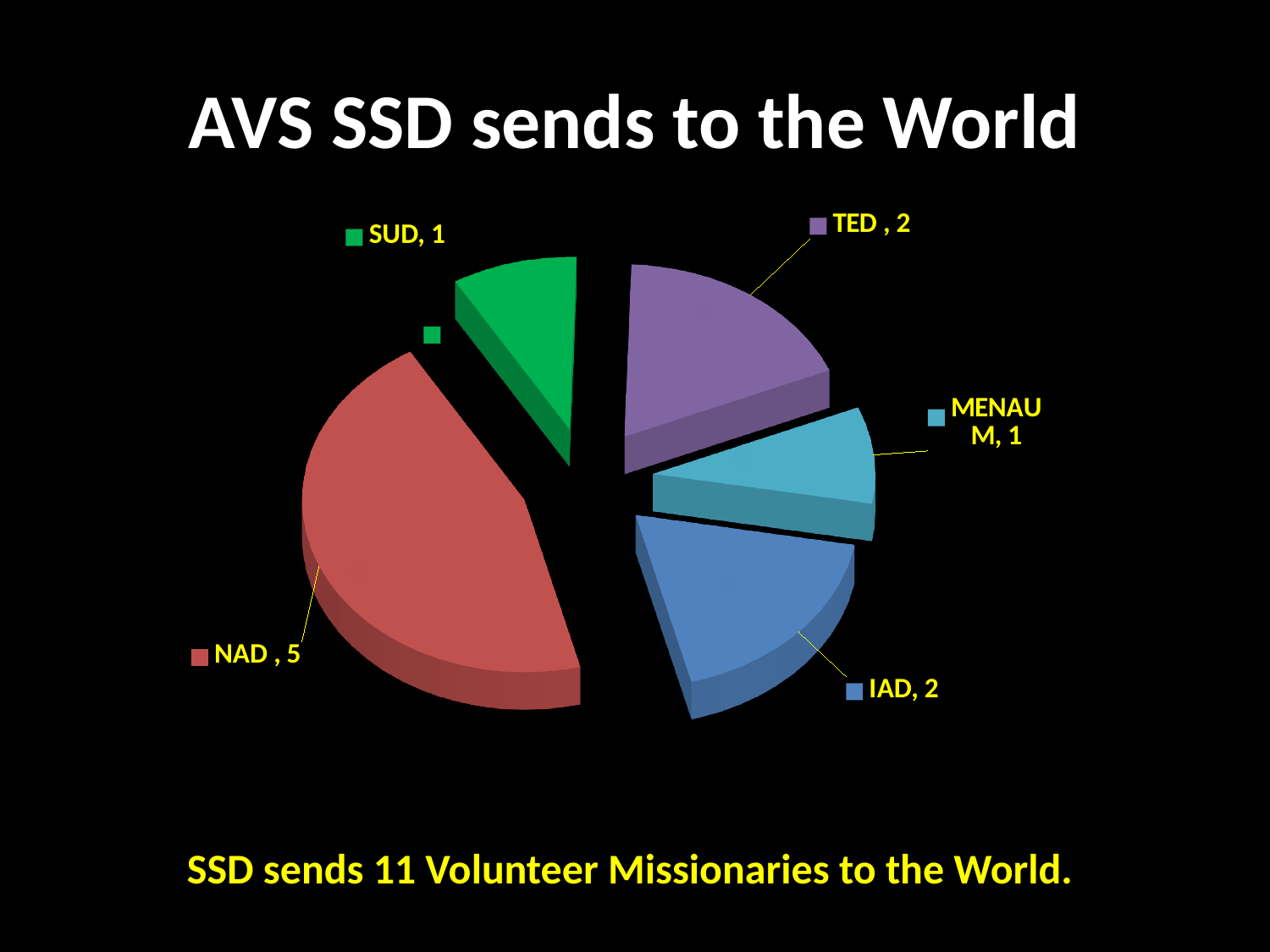
What is the total of all the values shown in the pie chart? 11 What value is shown for TED in the pie chart? 2 What kind of chart is shown on the slide? pie chart What value is shown for IAD in the pie chart? 2 What is the difference between the values for NAD and TED? 3 What value is shown for MENAUM in the pie chart? 1 Which division has the largest slice of the pie chart? NAD What colour is the NAD slice in the pie chart? red Which is larger, the value for IAD or the value for SUD? IAD What value is shown for NAD in the pie chart? 5 What value is shown for SUD in the pie chart? 1 What is the title of the slide containing the chart? AVS SSD sends to the World